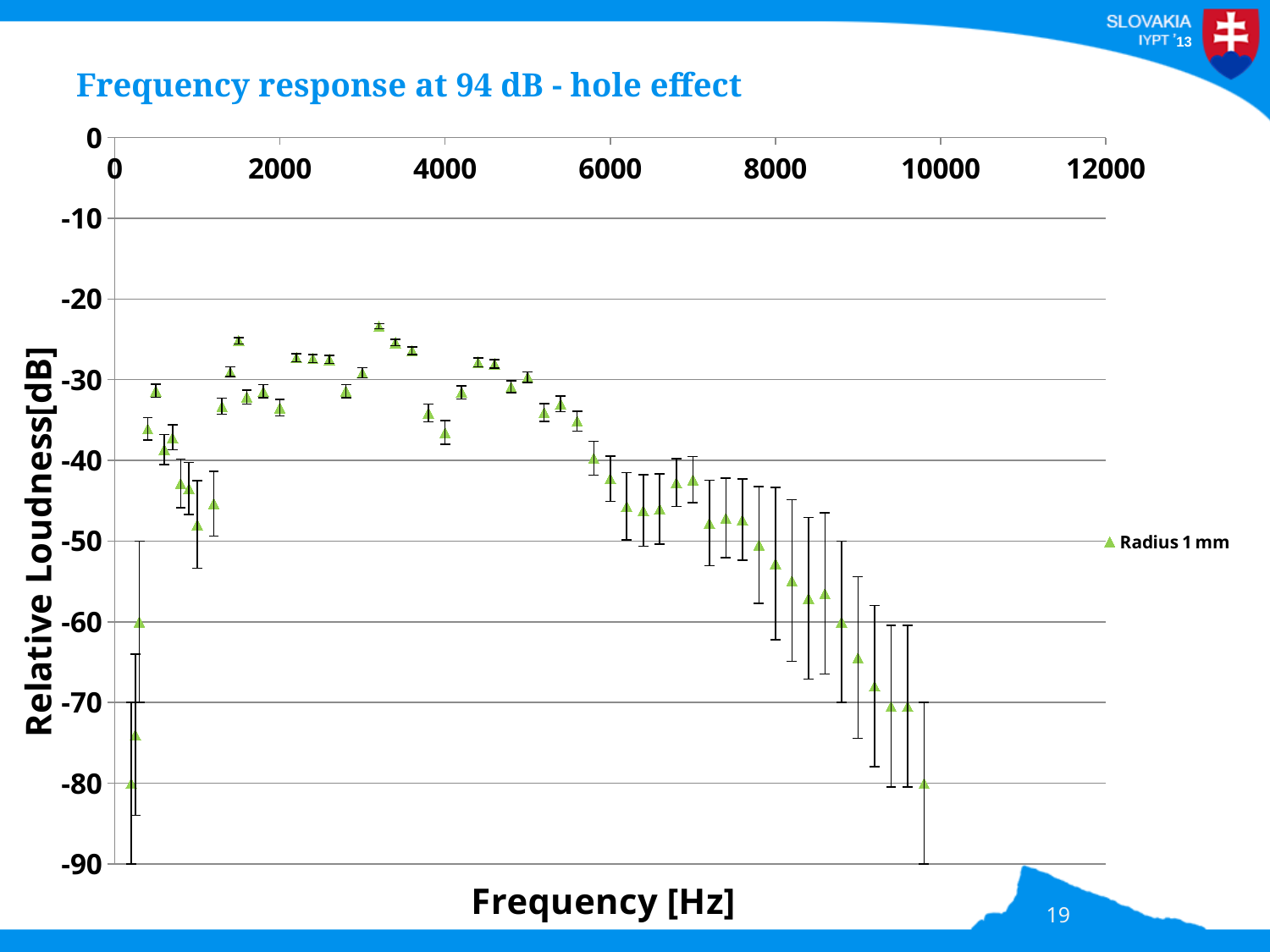
Is the relative loudness at 8000 Hz greater or less than -40 dB? less What is the name of the series shown in the legend? Radius 1 mm What kind of chart is shown on the slide? scatter chart Is the relative loudness of the last data point near 10000 Hz greater or less than -60 dB? less Which is larger, the relative loudness at 2000 Hz or at 8000 Hz? 2000 Hz Is the relative loudness at 2000 Hz greater or less than -40 dB? greater Do the relative loudness values rise or fall as frequency increases from 6000 Hz to 10000 Hz? fall What is the title of the chart? Frequency response at 94 dB - hole effect How many series does the legend list? 1 Which is larger, the relative loudness at 4000 Hz or at 6000 Hz? 4000 Hz